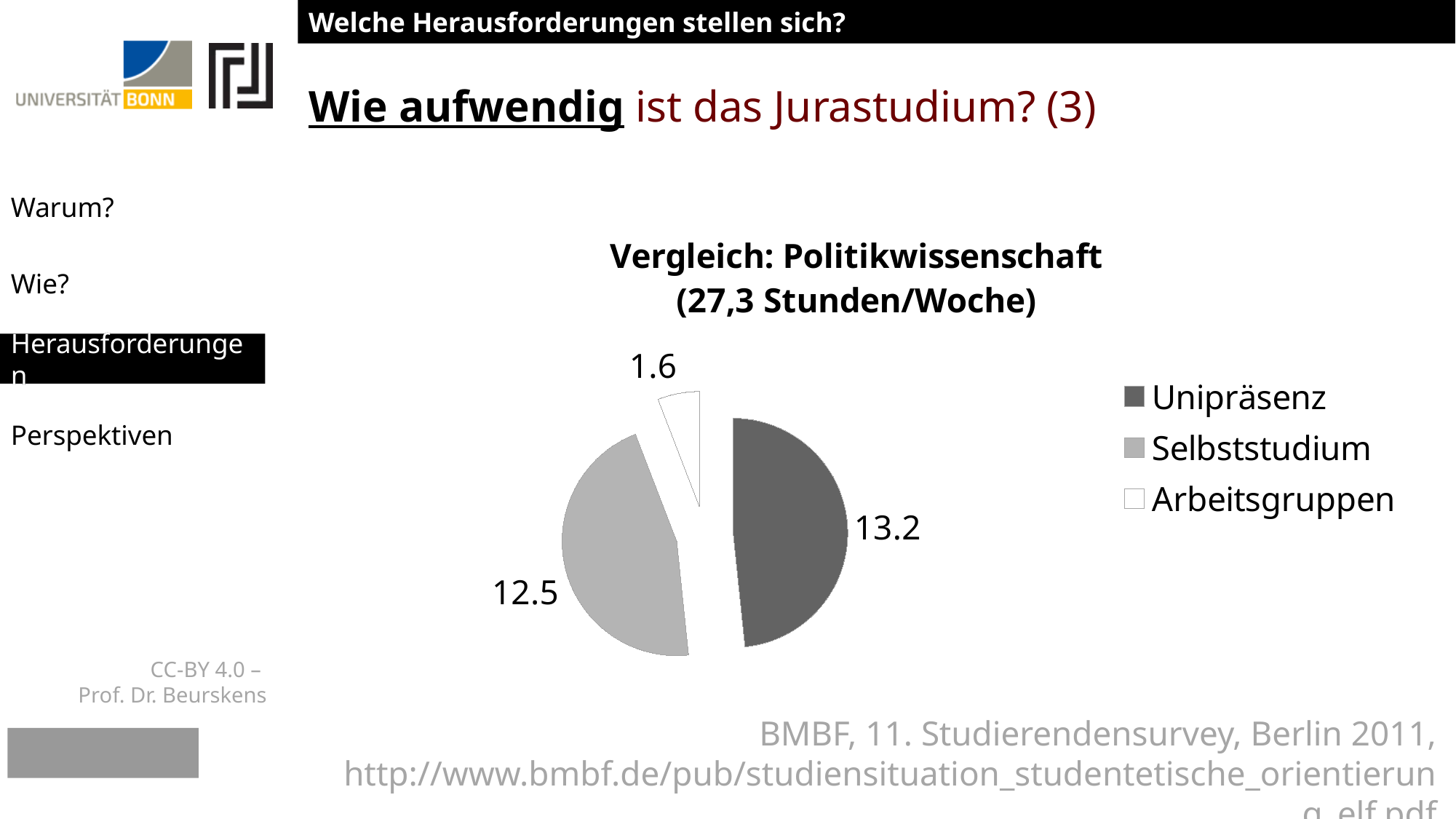
What is the title of the pie chart? Vergleich: Politikwissenschaft (27,3 Stunden/Woche) How many slices does the pie chart have? 3 What is the value for Selbststudium in the pie chart? 12.5 What is the value for Unipräsenz in the pie chart? 13.2 What is the difference between the values for Selbststudium and Arbeitsgruppen? 10.9 Which category has the largest slice in the pie chart? Unipräsenz Which is larger, the value for Selbststudium or the value for Arbeitsgruppen? Selbststudium What is the value for Arbeitsgruppen in the pie chart? 1.6 Which category has the smallest slice in the pie chart? Arbeitsgruppen How many entries does the legend of the pie chart list? 3 What kind of chart is shown on the slide? pie chart What is the difference between the values for Unipräsenz and Selbststudium? 0.7